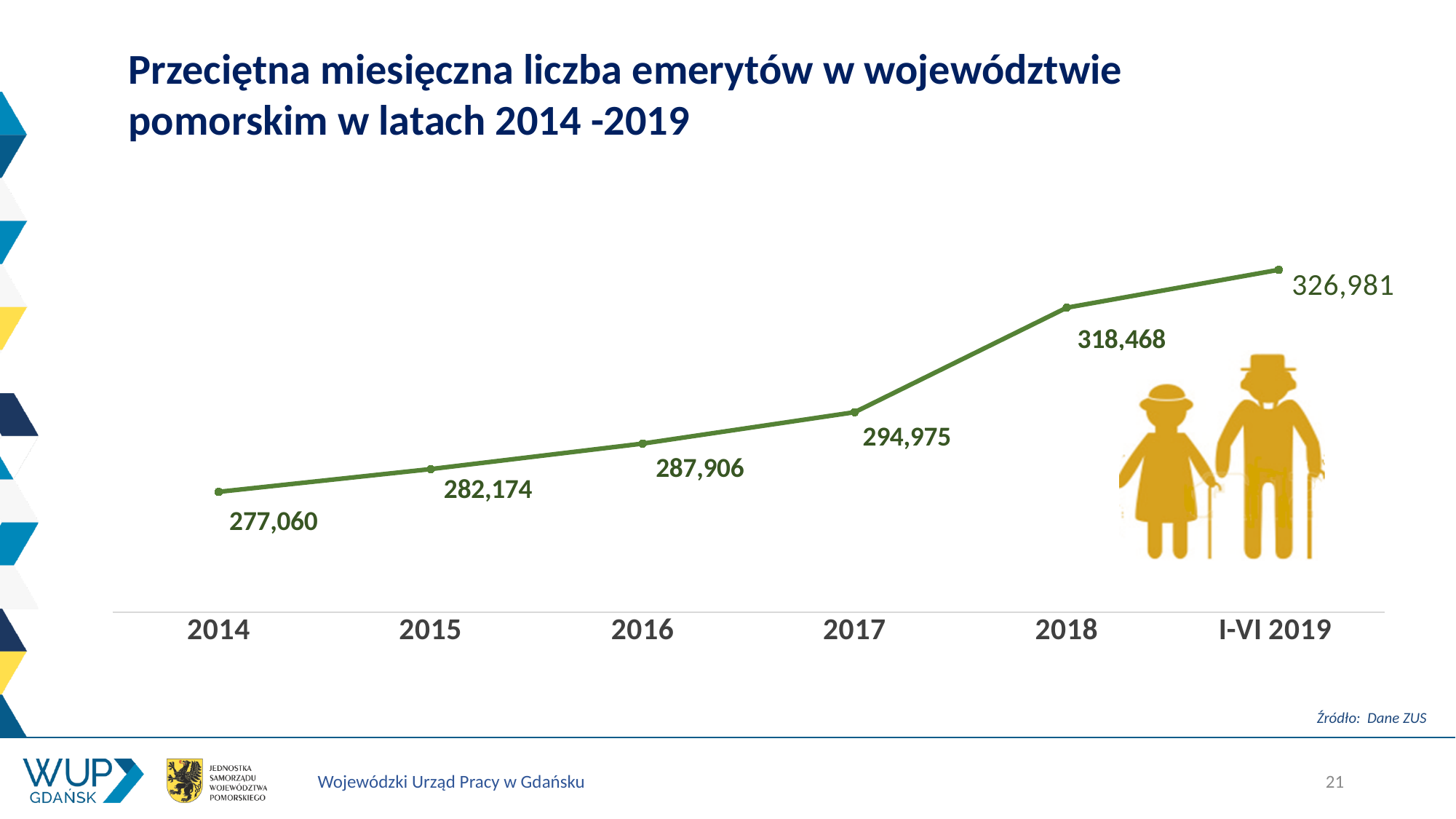
What value is shown for 2017? 294,975 What is the source given for the chart data? Dane ZUS What value is shown for I-VI 2019? 326,981 What type of chart is shown on the slide? line chart How many data points are plotted on the chart? 6 Do the values rise or fall from 2014 to I-VI 2019? rise What is the difference between the values for 2018 and 2017? 23,493 Which year has the lowest value on the chart? 2014 What is the difference between the values for 2016 and 2015? 5,732 Which is larger, the value for 2015 or the value for 2016? 2016 What is the average monthly number of pensioners in 2014? 277,060 Which period has the highest value on the chart? I-VI 2019